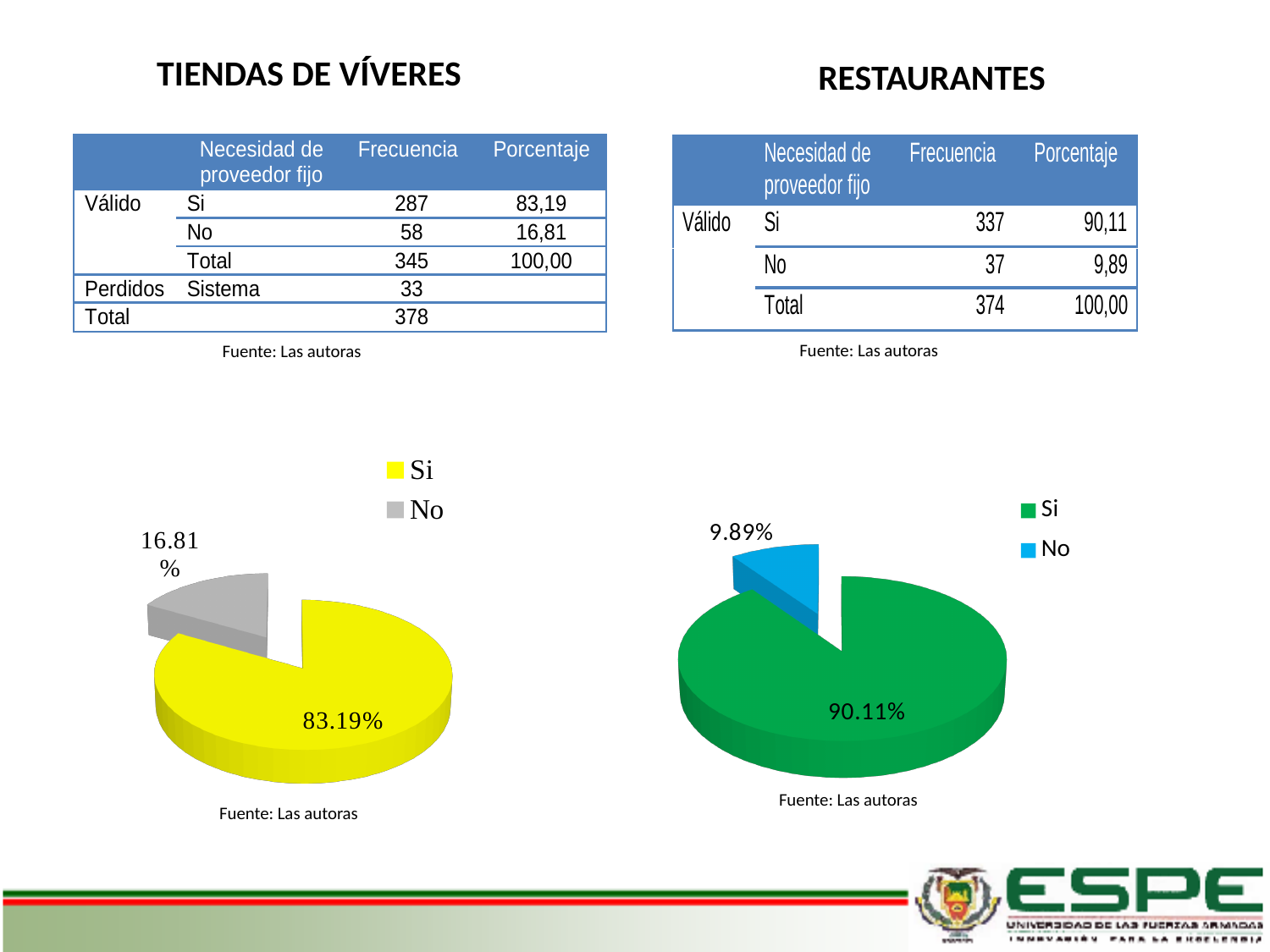
What type of chart is used on the right side of the slide for Restaurantes? Pie chart How many slices does the left pie chart (Tiendas de Víveres) have? 2 In the left pie chart (Tiendas de Víveres), what percentage is shown for the 'No' slice? 16.81% In the right pie chart (Restaurantes), what is the difference in percentage points between the 'Si' and 'No' slices? 80.22 In the left pie chart (Tiendas de Víveres), which category has the largest slice? Si Which chart has the larger 'Si' slice, the left pie chart (Tiendas de Víveres) or the right pie chart (Restaurantes)? The right pie chart (Restaurantes) In the left pie chart (Tiendas de Víveres), what percentage is shown for the 'Si' slice? 83.19% In the left pie chart (Tiendas de Víveres), what is the difference in percentage points between the 'Si' and 'No' slices? 66.38 In the right pie chart (Restaurantes), what percentage is shown for the 'No' slice? 9.89% In the right pie chart (Restaurantes), what percentage is shown for the 'Si' slice? 90.11% In the right pie chart (Restaurantes), which category has the smallest slice? No In the right pie chart (Restaurantes), what colour is the 'Si' slice? Green